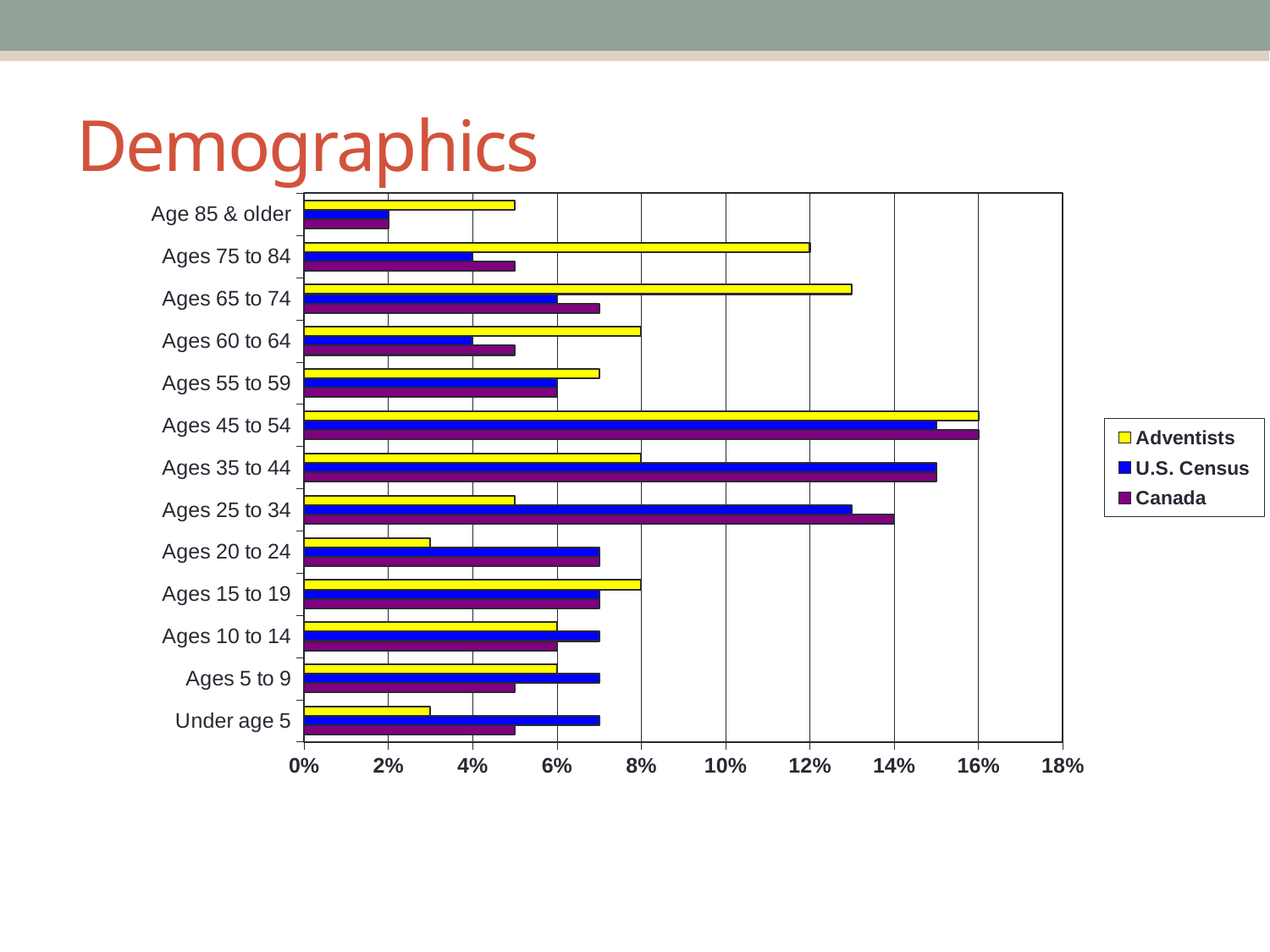
Which colour represents the Adventists series in the legend? yellow How many age categories are plotted on the chart? 13 Which age category has the lowest Canada value? Age 85 & older What is the difference between the Adventists value and the U.S. Census value for Ages 75 to 84? 8% What is the Adventists value for Ages 45 to 54? 16% What kind of chart is shown on the slide? bar chart Is the Adventists value for Ages 65 to 74 greater or less than 12%? greater Which age category has the highest Adventists value? Ages 45 to 54 For Ages 35 to 44, which is larger: the Adventists value or the U.S. Census value? U.S. Census How many series does the legend list? 3 What is the Adventists value for Ages 75 to 84? 12% What is the Canada value for Ages 25 to 34? 14%